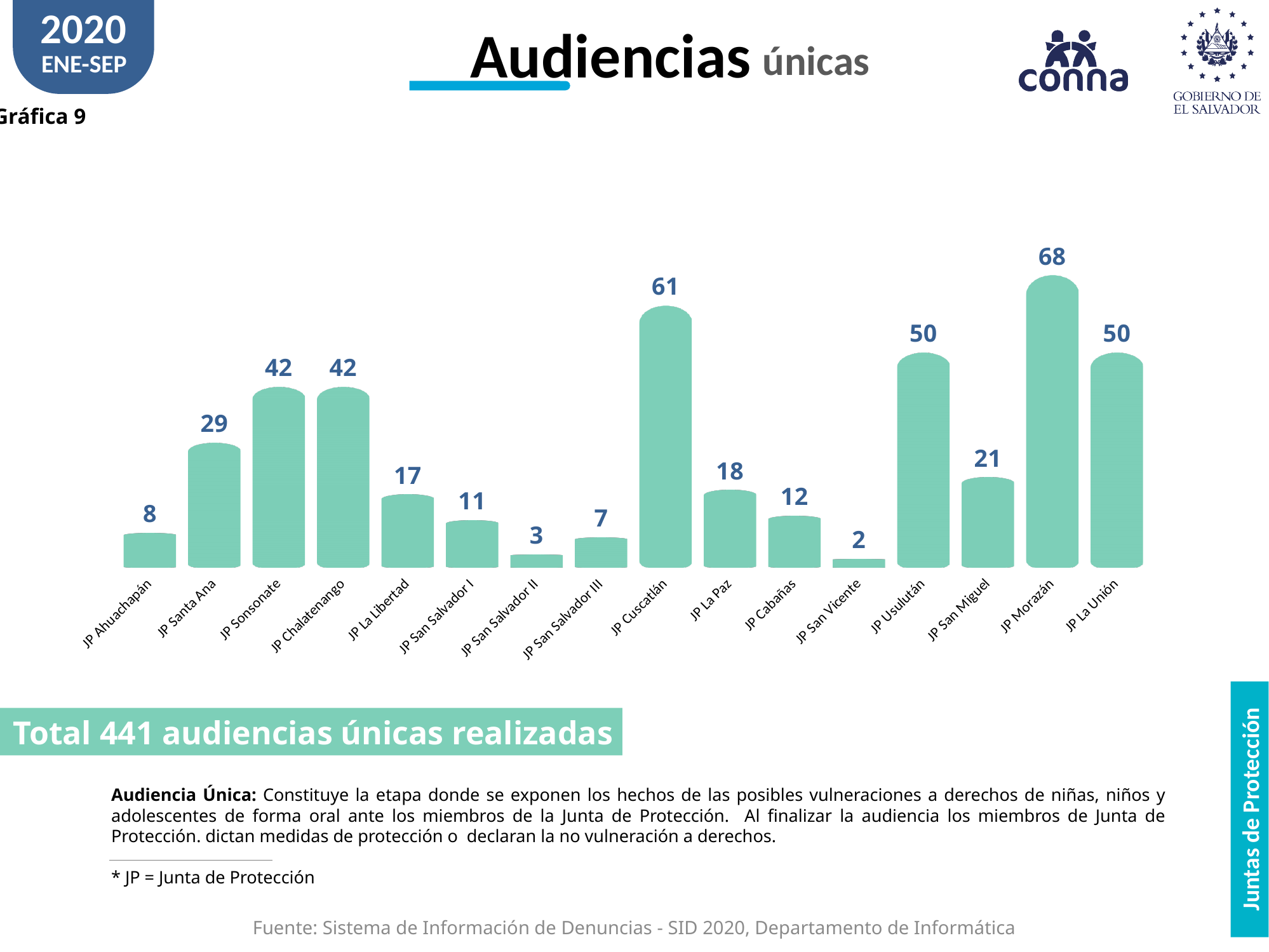
What is the value for JP La Paz? 18 What is the difference between the values for JP Morazán and JP Cuscatlán? 7 What kind of chart is shown on the slide? Bar chart Which category has the highest value? JP Morazán How many categories are shown in the chart? 16 What total number of audiencias únicas does the slide report? 441 What is the value for JP San Salvador II? 3 Which category has the lowest value? JP San Vicente What is the title of the chart? Audiencias únicas What is the difference between the values for JP Usulután and JP San Miguel? 29 What is the value for JP Cuscatlán? 61 Which is larger, the value for JP Santa Ana or the value for JP San Miguel? JP Santa Ana